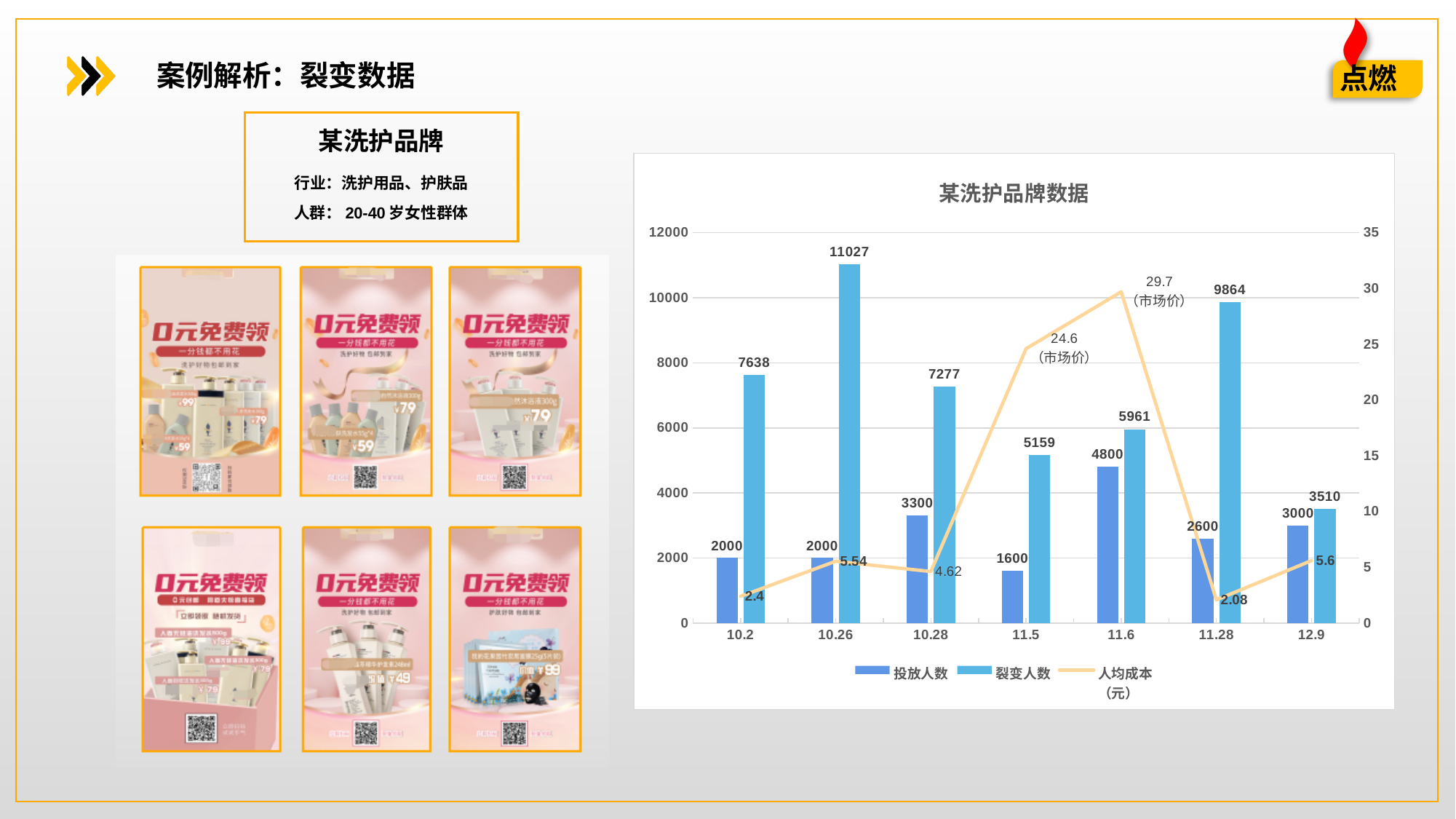
Which date has the highest 裂变人数? 10.26 How many dates are shown on the x axis? 7 What is the 人均成本（元） value for 11.28? 2.08 What is the 裂变人数 value for 10.26? 11027 Which date has the lowest 投放人数? 11.5 What is the difference between 裂变人数 and 投放人数 on 11.28? 7264 What is the 投放人数 value for 11.6? 4800 What kind of chart is this? Combined bar and line chart Which is larger, the 裂变人数 on 10.2 or on 10.28? 10.2 How many series does the legend list? 3 What is the title of the chart? 某洗护品牌数据 Does the 裂变人数 rise or fall from 11.28 to 12.9? Fall